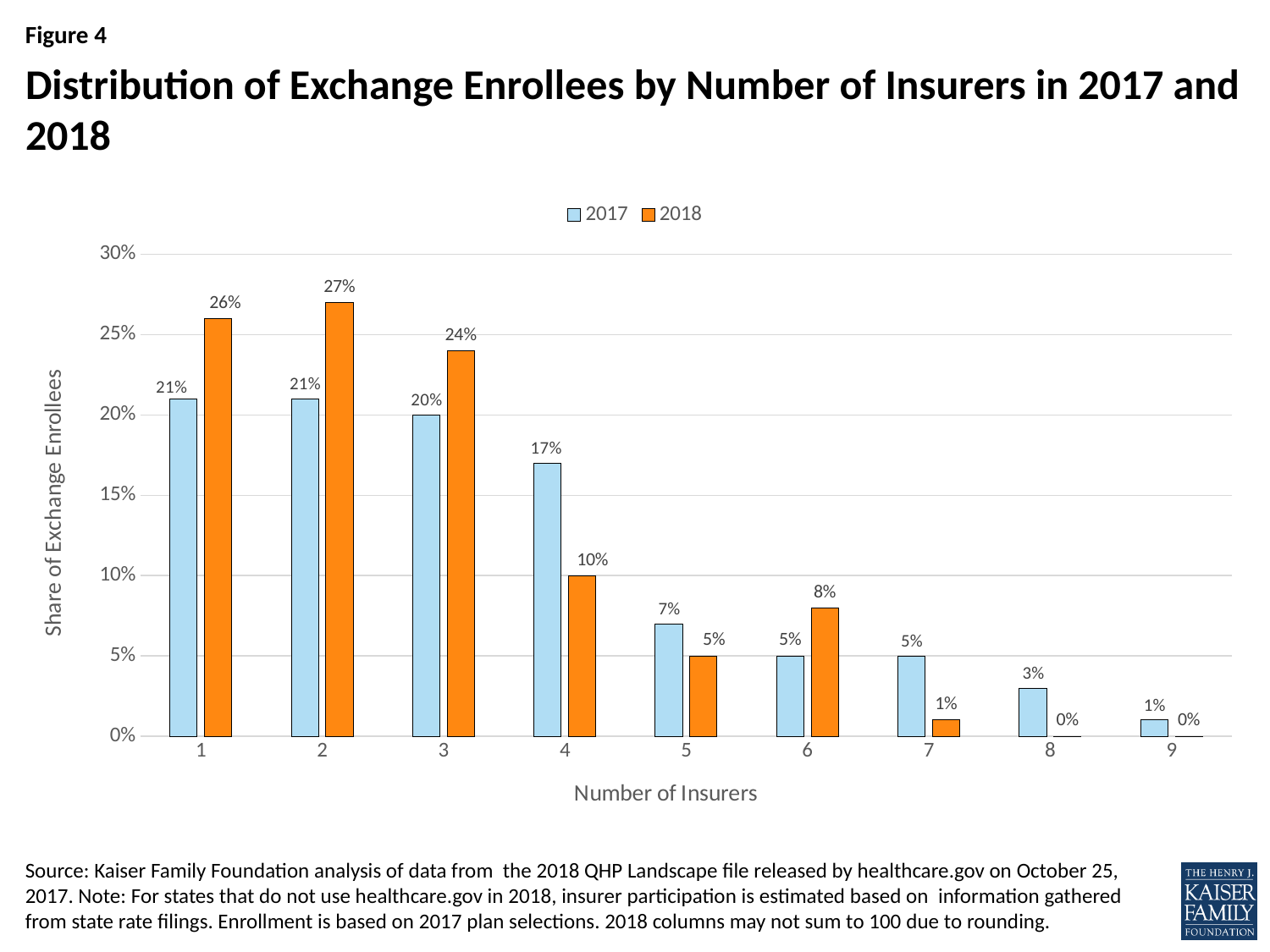
Which number of insurers has the lowest share of enrollees in 2017? 9 What share of exchange enrollees had 1 insurer in 2018? 26% What is the 2018 value for 7 insurers? 1% What is the difference between the 2018 and 2017 shares for 2 insurers? 6% What share of exchange enrollees had 4 insurers in 2017? 17% For 6 insurers, which year has the larger share of enrollees, 2017 or 2018? 2018 Which number of insurers has the highest share of enrollees in 2018? 2 How many categories (numbers of insurers) are shown on the x axis? 9 How many series does the legend list? 2 Is the 2017 value for 3 insurers greater or less than 15%? greater What is the label of the y axis? Share of Exchange Enrollees What kind of chart is shown on the slide? Bar chart